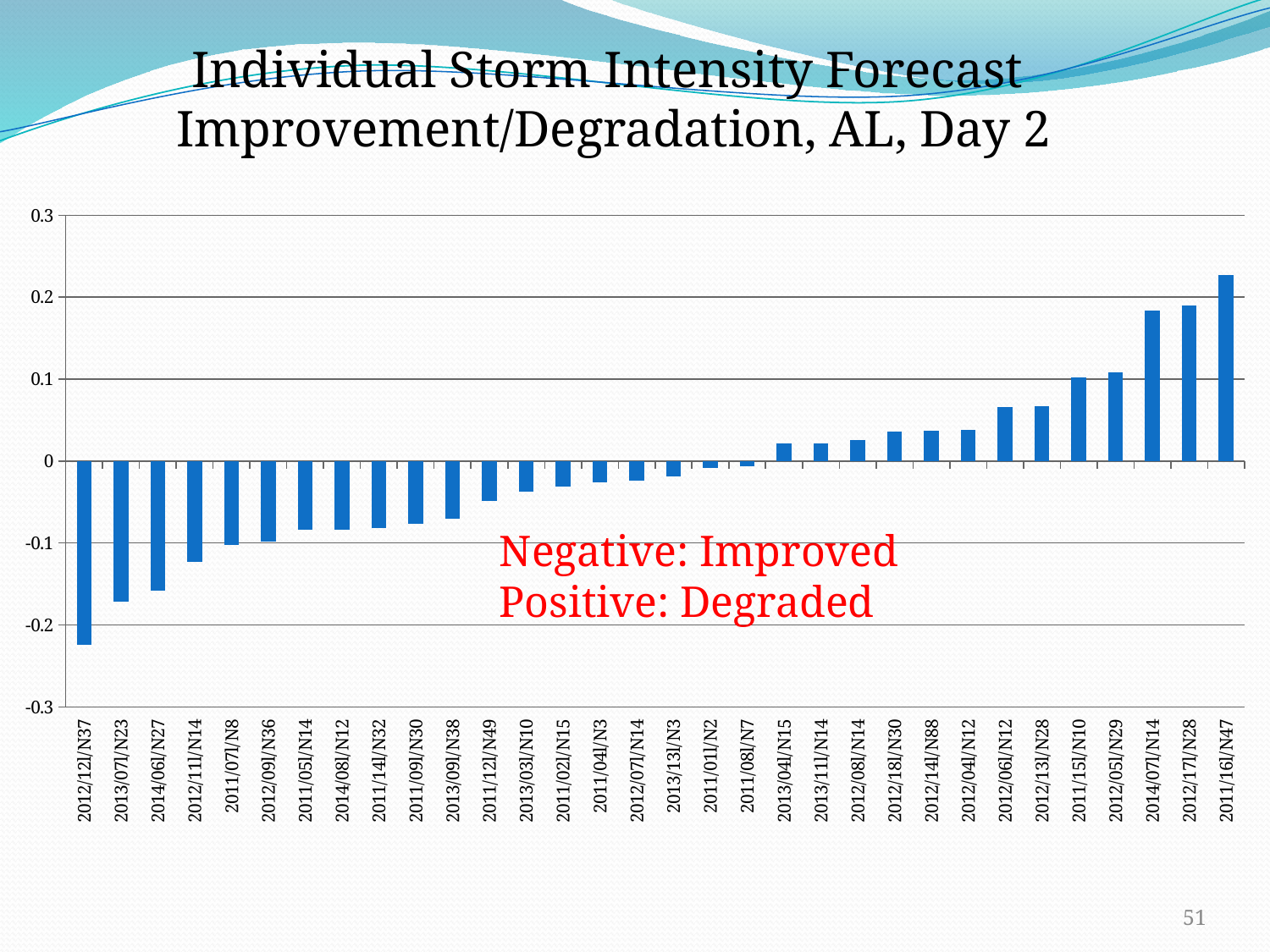
Which has the larger value, 2012/12l/N37 or 2012/11l/N14? 2012/11l/N14 Is the value for 2014/07l/N14 greater or less than 0.2? less Is the value for 2012/12l/N37 greater or less than -0.2? less Is the value for 2012/11l/N14 greater or less than -0.1? less What is the title of the chart? Individual Storm Intensity Forecast Improvement/Degradation, AL, Day 2 How many storms (bars) are plotted in the chart? 32 What kind of chart is shown on the slide? Bar chart Which storm has the lowest (most negative) value? 2012/12l/N37 According to the red text on the chart, what does a negative value indicate? Improved Which storm has the highest (most positive) value? 2011/16l/N47 Do the bar values rise or fall moving from left to right along the x axis? Rise